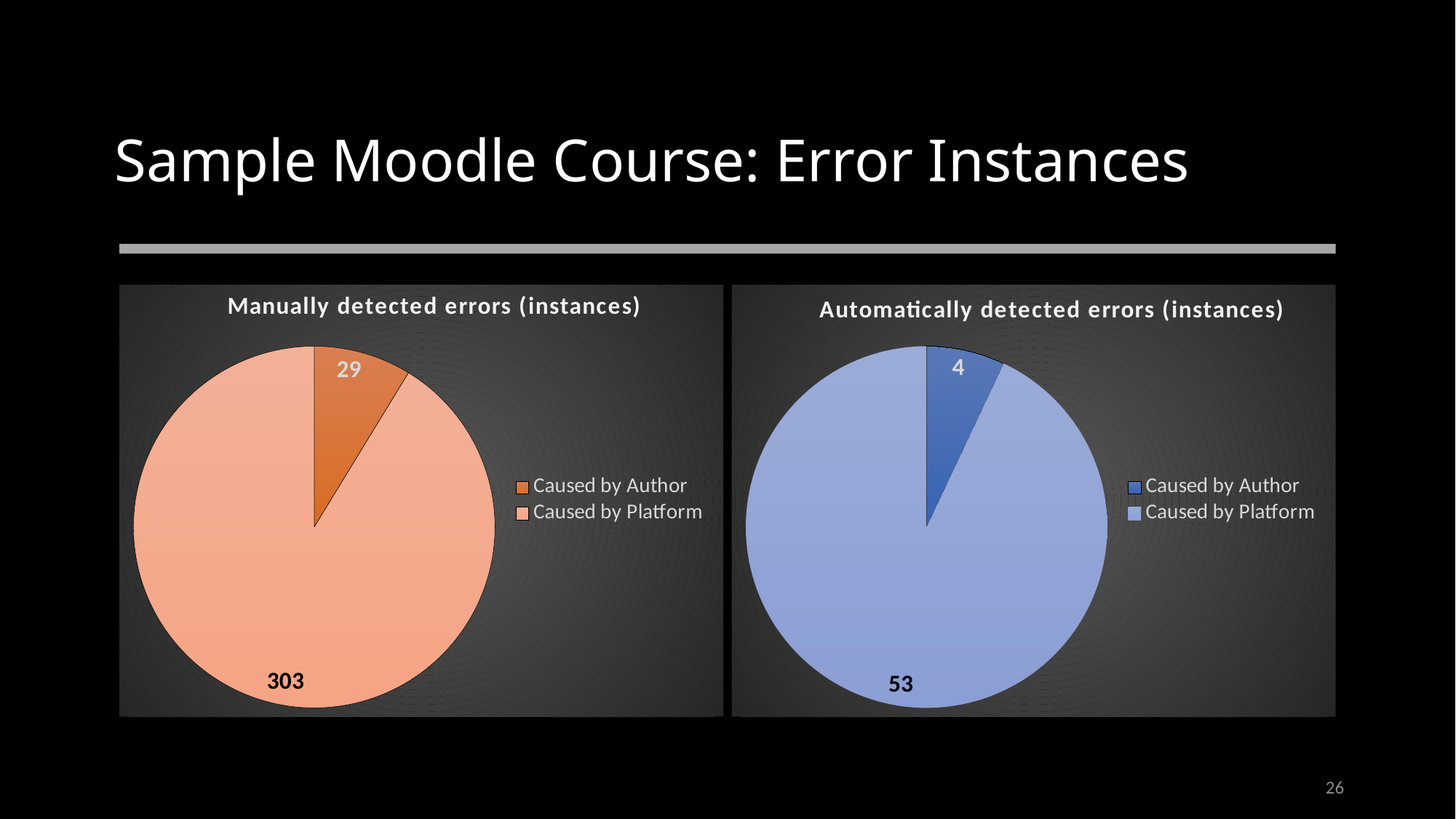
In the 'Manually detected errors (instances)' chart, which category has the largest slice? Caused by Platform In the 'Automatically detected errors (instances)' chart, how many instances were caused by the platform? 53 How many categories does the legend of the 'Manually detected errors (instances)' chart list? 2 What is the total number of instances shown in the 'Manually detected errors (instances)' chart? 332 What is the total number of instances shown in the 'Automatically detected errors (instances)' chart? 57 In the 'Manually detected errors (instances)' chart, what is the difference between the instances caused by the platform and those caused by the author? 274 In the 'Automatically detected errors (instances)' chart, what is the difference between the instances caused by the platform and those caused by the author? 49 In the 'Manually detected errors (instances)' chart, how many instances were caused by the platform? 303 In the 'Automatically detected errors (instances)' chart, which category has the smallest slice? Caused by Author In the 'Automatically detected errors (instances)' chart, how many instances were caused by the author? 4 What type of chart is used for 'Automatically detected errors (instances)'? Pie chart In the 'Manually detected errors (instances)' chart, how many instances were caused by the author? 29